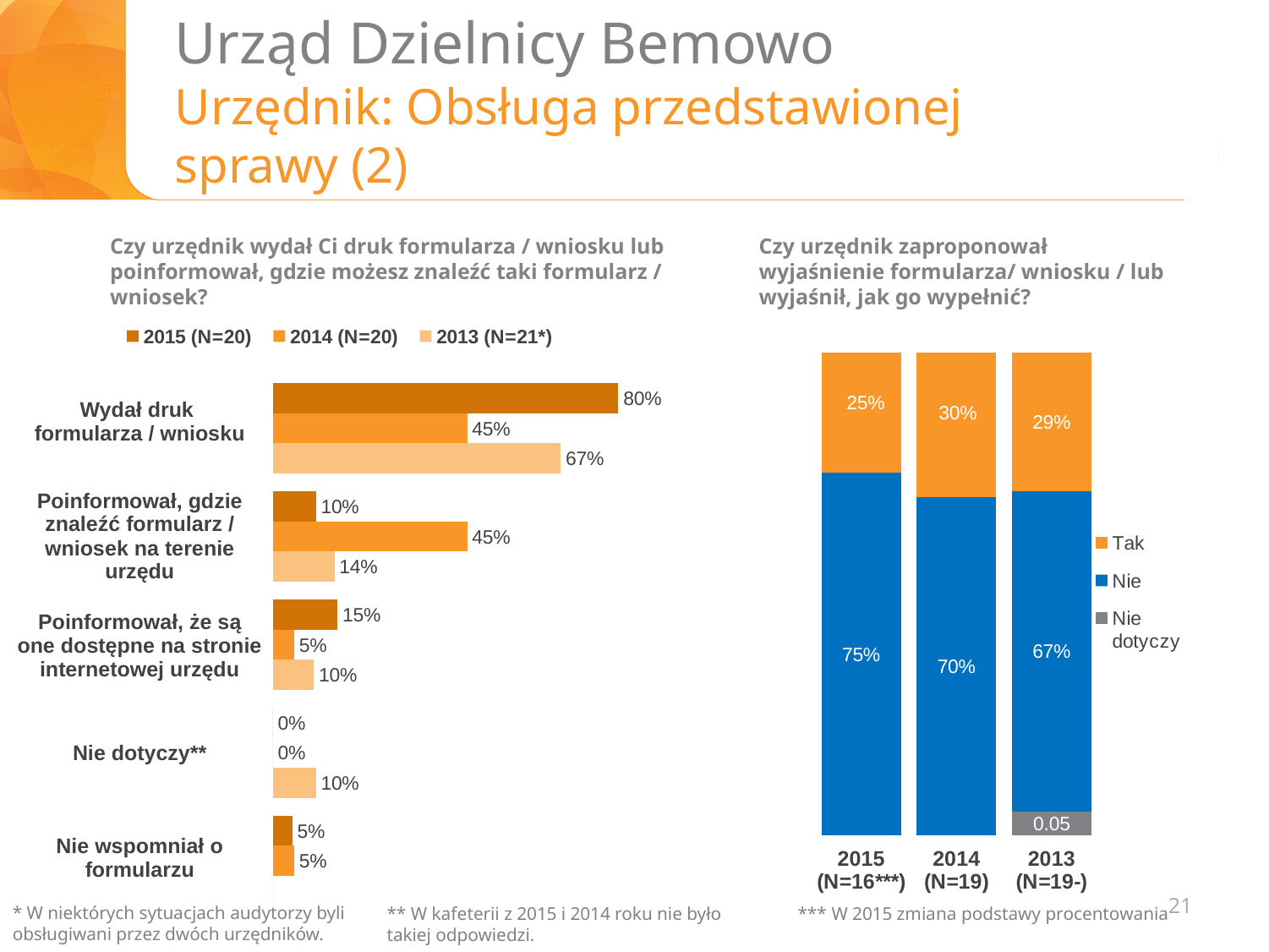
What kind of chart is the left chart? Bar chart In the left chart, what is the 2015 value for "Wydał druk formularza / wniosku"? 80% In the left chart, which category has the highest 2015 value? Wydał druk formularza / wniosku In the right chart, what is the "Nie" value for 2014? 70% In the left chart, what is the 2014 value for "Poinformował, gdzie znaleźć formularz / wniosek na terenie urzędu"? 45% In the left chart, for "Poinformował, że są one dostępne na stronie internetowej urzędu", which is larger: the 2015 value or the 2014 value? 2015 In the right chart, which year has the highest "Nie" value? 2015 How many series does the legend of the right chart list? 3 In the right chart, what is the "Tak" value for 2013? 29% In the left chart, what is the difference between the 2015 and 2014 values for "Wydał druk formularza / wniosku"? 35 percentage points In the left chart, what is the 2013 value for "Nie dotyczy**"? 10% How many series does the legend of the left chart list? 3